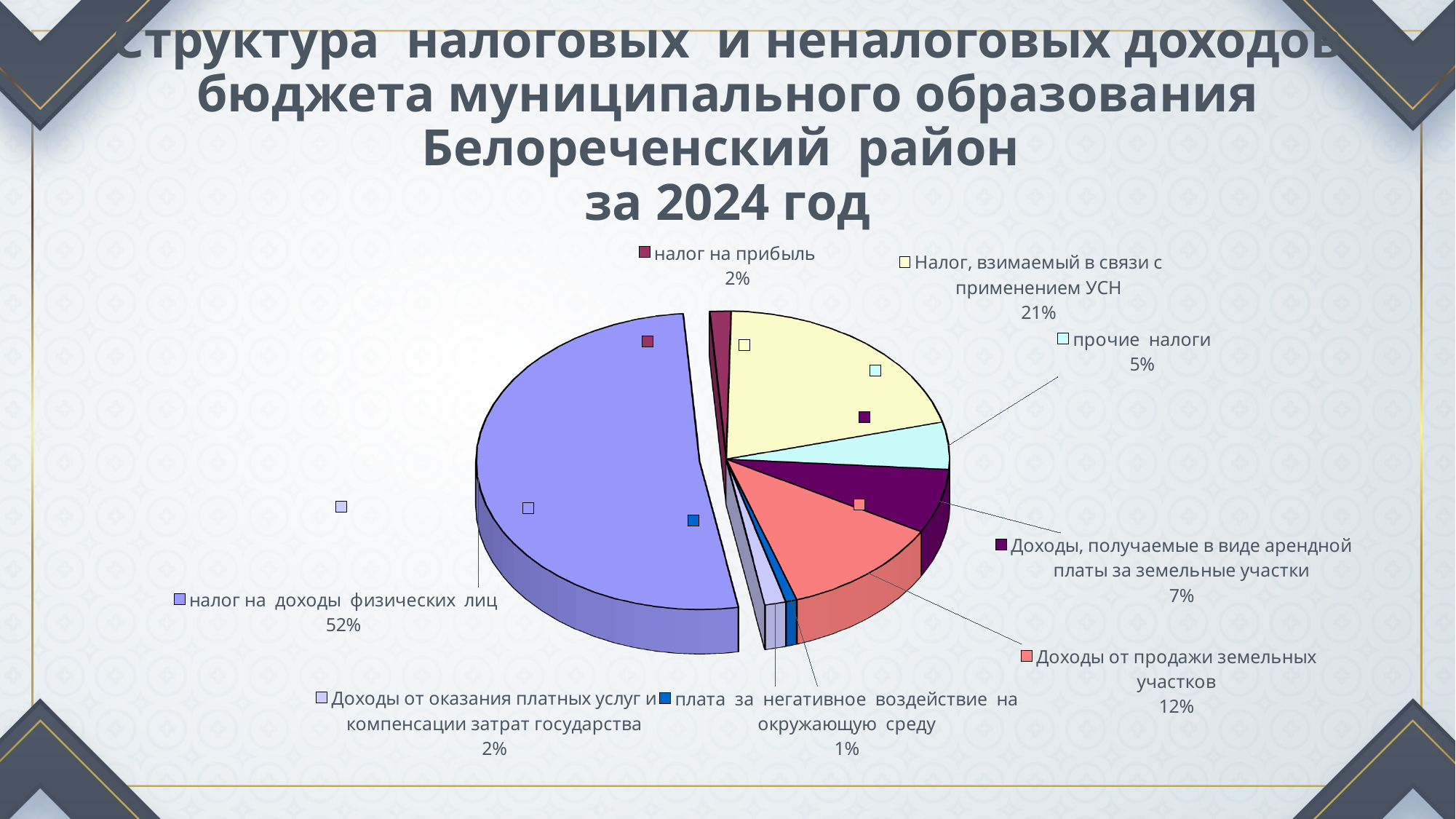
What is the value shown for "Доходы от продажи земельных участков"? 12% What is the value shown for "прочие налоги"? 5% What share of the pie does "Налог, взимаемый в связи с применением УСН" have? 21% Which category has the smallest share of the pie? плата за негативное воздействие на окружающую среду What type of chart is shown on the slide? pie chart What is the value shown for "плата за негативное воздействие на окружающую среду"? 1% Which is larger: the share for "Доходы от продажи земельных участков" or the share for "Доходы, получаемые в виде арендной платы за земельные участки"? Доходы от продажи земельных участков Which category has the largest share of the pie? налог на доходы физических лиц How many slices does the pie chart have? 8 What is the difference in percentage points between "налог на доходы физических лиц" and "Налог, взимаемый в связи с применением УСН"? 31 What is the value shown for "Доходы, получаемые в виде арендной платы за земельные участки"? 7% What share of the pie does "налог на доходы физических лиц" have? 52%